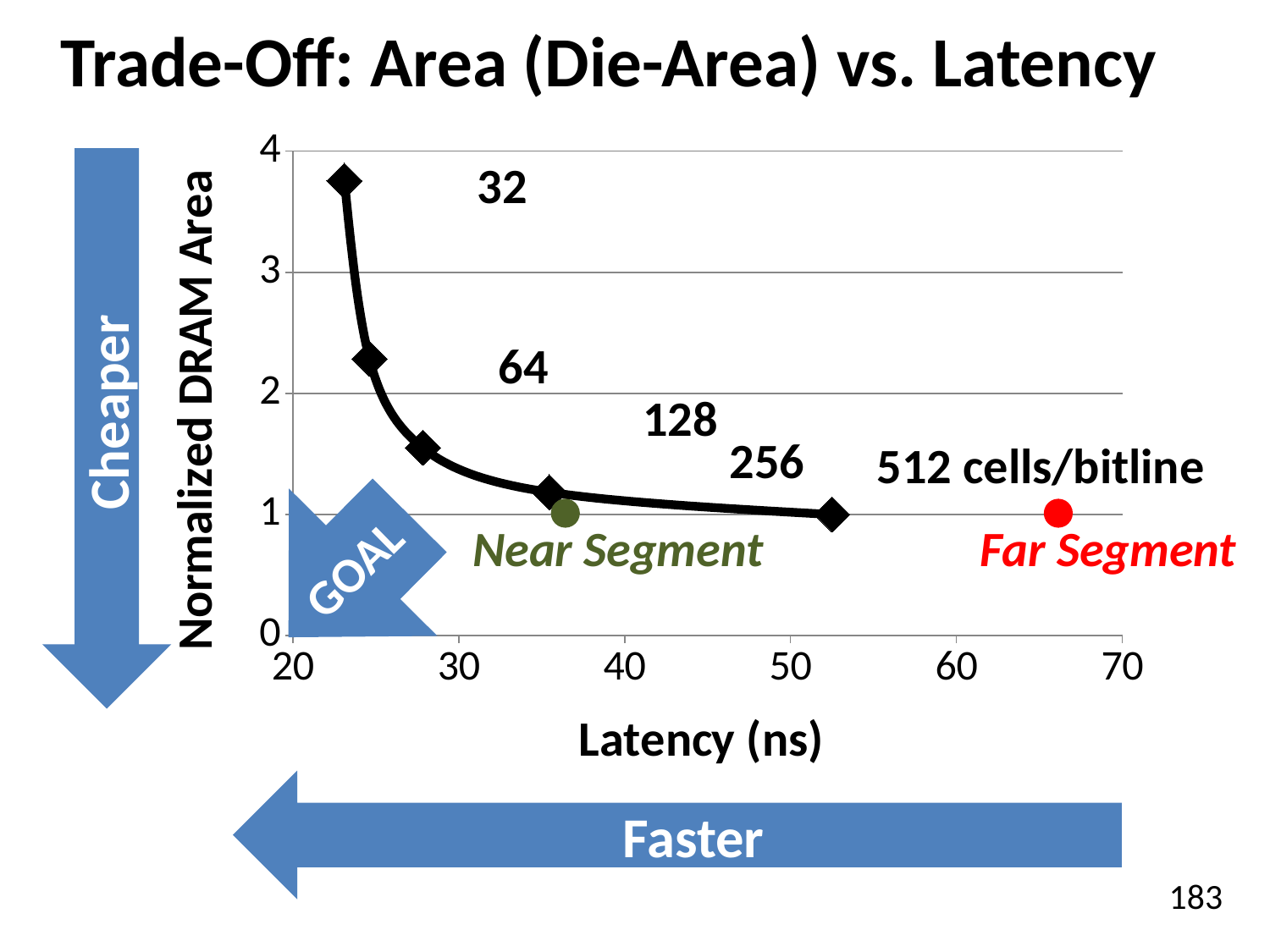
Which has the higher latency, the Near Segment or the Far Segment? Far Segment Which cells/bitline configuration has the lowest normalized DRAM area? 512 What is the title of the y axis? Normalized DRAM Area Is the normalized DRAM area for 64 cells/bitline greater or less than 2? greater How many cells/bitline data points are plotted on the black curve? 5 Is the normalized DRAM area for 32 cells/bitline greater or less than 3? greater What is the title of the x axis? Latency (ns) Is the latency for 512 cells/bitline greater or less than 50 ns? greater What kind of chart is shown on the slide? line chart Which cells/bitline configuration has the highest normalized DRAM area? 32 As latency increases along the x axis, does the normalized DRAM area rise or fall? fall